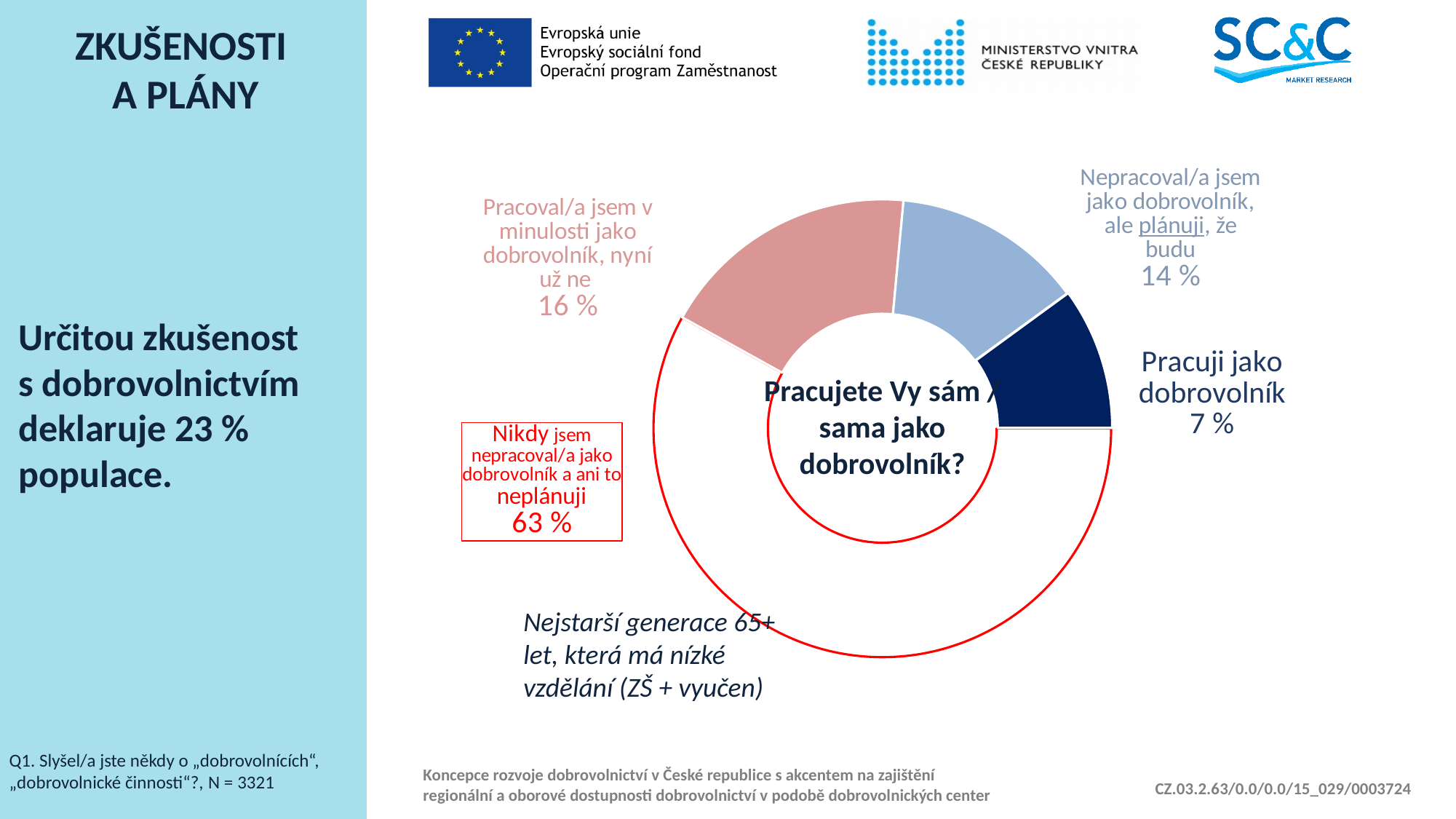
What is the difference in percentage points between those who never volunteered and do not plan to (63 %) and those who volunteered in the past but no longer do (16 %)? 47 percentage points Which answer category has the largest share in the chart? Nikdy jsem nepracoval/a jako dobrovolník a ani to neplánuji Which is larger: the share of people who plan to volunteer (14 %) or the share who currently volunteer (7 %)? Plan to volunteer (14 %) What question is written in the centre of the donut chart? Pracujete Vy sám / sama jako dobrovolník? What percentage of respondents answered "Nepracoval/a jsem jako dobrovolník, ale plánuji, že budu"? 14 % What percentage of respondents answered "Nikdy jsem nepracoval/a jako dobrovolník a ani to neplánuji"? 63 % What kind of chart is shown on the slide? Donut (pie) chart What is the combined share of respondents who currently volunteer (7 %) and those who volunteered in the past (16 %)? 23 % How many answer categories are shown in the chart? 4 Which answer category has the smallest share in the chart? Pracuji jako dobrovolník What percentage of respondents answered "Pracuji jako dobrovolník"? 7 % What percentage of respondents answered "Pracoval/a jsem v minulosti jako dobrovolník, nyní už ne"? 16 %